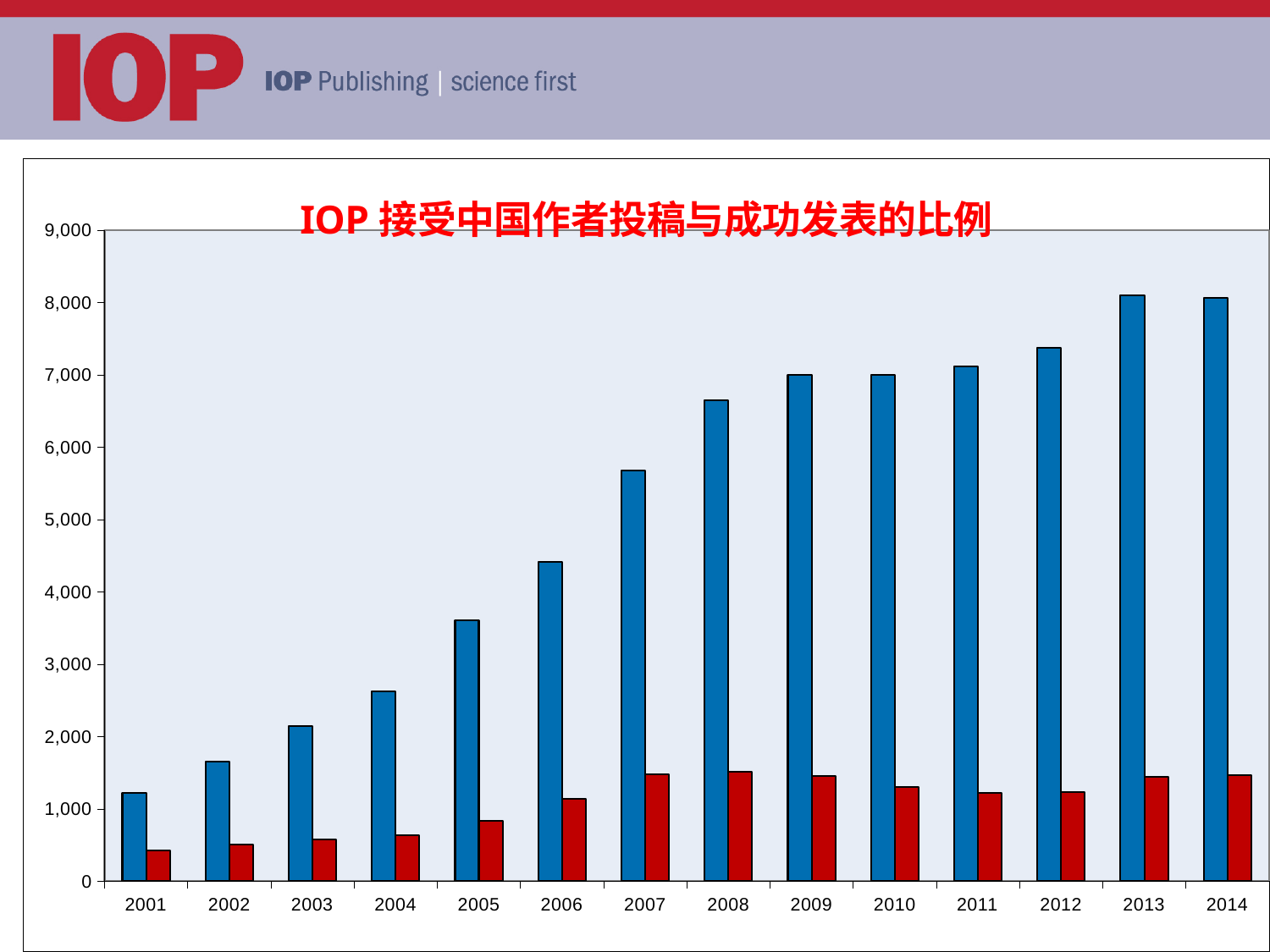
Do the blue bars generally rise or fall from 2001 to 2014? rise Is the value of the blue bar for 2005 greater or less than 3,000? greater Is the value of the blue bar for 2004 greater or less than 3,000? less What kind of chart is shown on the slide? bar chart Is the value of the blue bar for 2007 greater or less than 5,000? greater Which is larger, the blue bar for 2008 or the blue bar for 2006? 2008 What is the first year shown on the x axis? 2001 How many years are shown on the x axis of the chart? 14 What is the title of the chart? IOP 接受中国作者投稿与成功发表的比例 Which year has the lowest blue bar? 2001